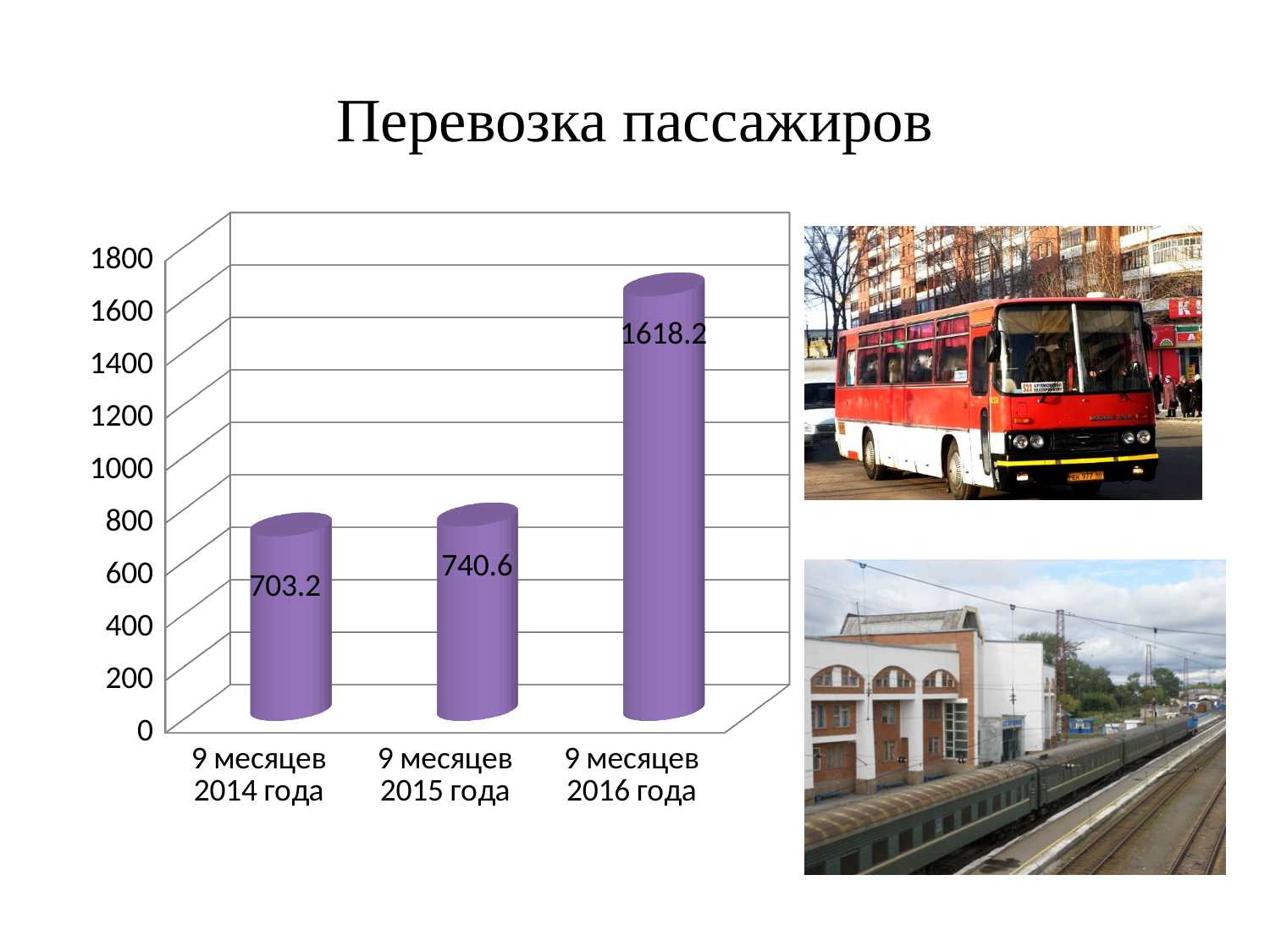
What is the value for 9 месяцев 2015 года? 740.6 What is the difference between the values for 9 месяцев 2015 года and 9 месяцев 2014 года? 37.4 What is the value for 9 месяцев 2016 года? 1618.2 Is the value for 9 месяцев 2016 года greater or less than 1400? greater What is the difference between the values for 9 месяцев 2016 года and 9 месяцев 2015 года? 877.6 Which category has the lowest value? 9 месяцев 2014 года What is the value for 9 месяцев 2014 года? 703.2 What is the title of the slide? Перевозка пассажиров What kind of chart is shown on the slide? bar chart Which is larger, the value for 9 месяцев 2015 года or 9 месяцев 2014 года? 9 месяцев 2015 года How many categories are shown on the chart? 3 Which category has the highest value? 9 месяцев 2016 года